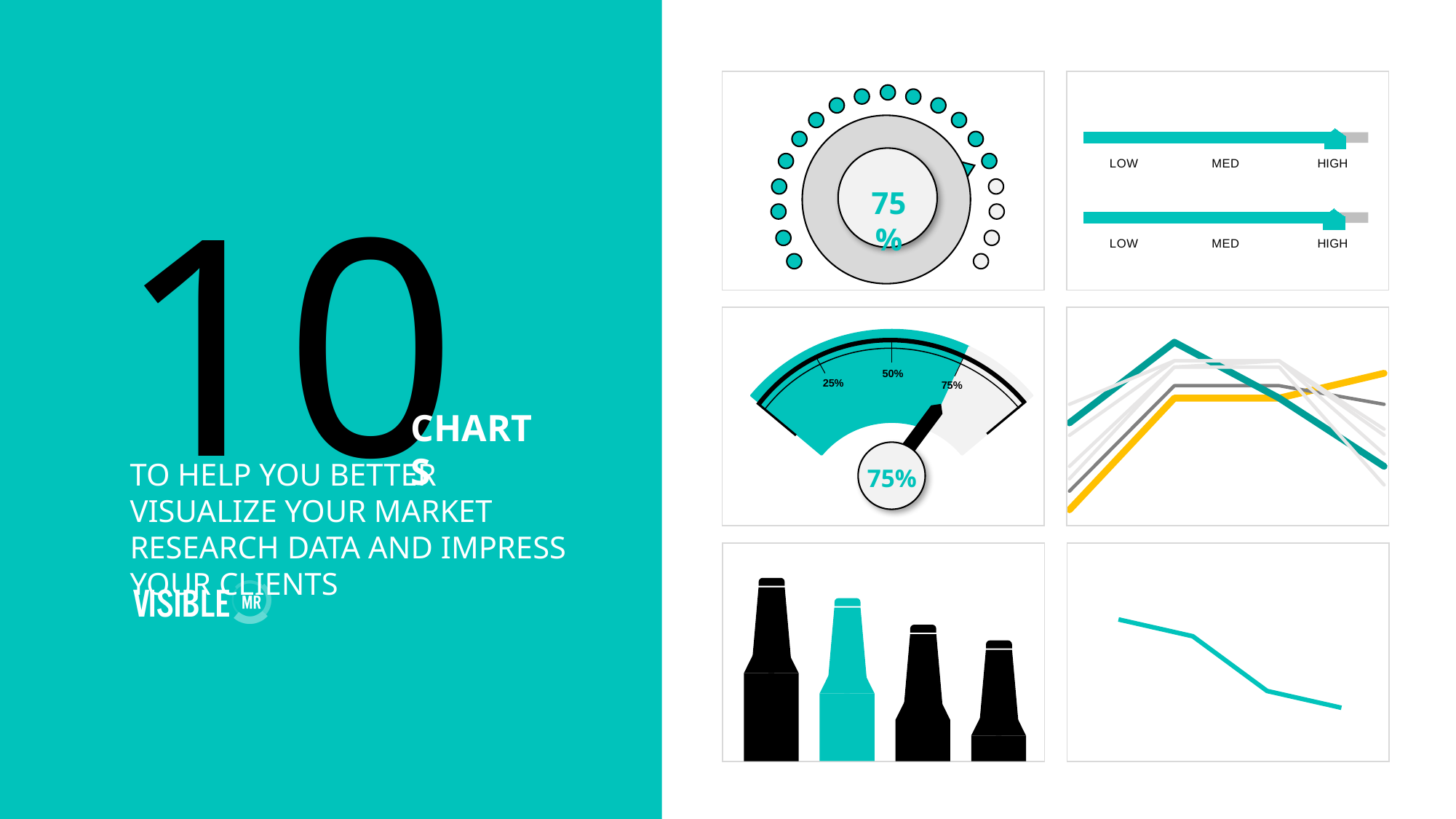
On the gauge chart in the middle-left panel, what are the tick labels printed along the arc? 25%, 50%, 75% On the bottle chart in the bottom-left panel, which bottle is the tallest, counting from the left? the first On the gauge chart in the middle-left panel, what value does the needle indicate? 75% On the gauge chart in the middle-left panel, how many tick labels are printed along the arc? 3 On the bottle chart in the bottom-left panel, how many bottles are shown? 4 On the slider chart in the top-right panel, what are the three labels under each slider? LOW, MED, HIGH On the slider chart in the top-right panel, how many sliders are shown? 2 On the bottle chart in the bottom-left panel, which bottle is the shortest, counting from the left? the fourth What kind of chart is shown in the bottom-right panel? line chart On the slider chart in the top-right panel, which label is the top slider's marker positioned at? HIGH On the line chart in the bottom-right panel, do the values rise or fall from left to right? fall On the dial chart in the top-left panel, what percentage value is shown in the centre? 75%